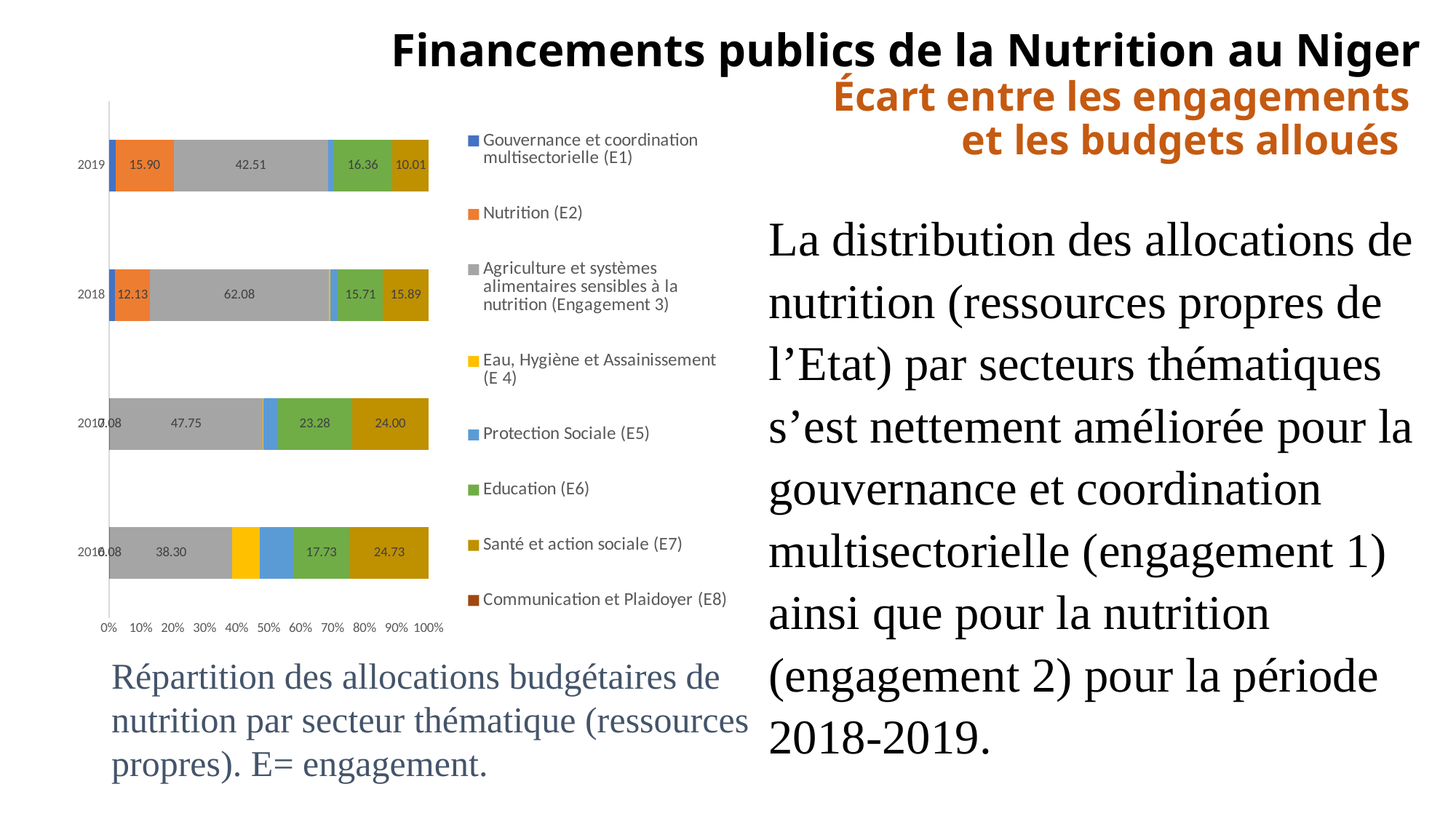
What kind of chart is shown on the slide? Stacked bar chart Which year has the larger value for Agriculture et systèmes alimentaires sensibles à la nutrition (Engagement 3), 2018 or 2019? 2018 What is the difference between the Nutrition (E2) value in 2019 and in 2018? 3.77 What is the value for Nutrition (E2) in 2018? 12.13 What is the value for Santé et action sociale (E7) in the bottom bar of the chart? 24.73 What is the value for Education (E6) in 2018? 15.71 How many series does the chart legend list? 8 Which series has the largest labelled segment in the 2019 bar? Agriculture et systèmes alimentaires sensibles à la nutrition (Engagement 3) What is the value for Agriculture et systèmes alimentaires sensibles à la nutrition (Engagement 3) in 2019? 42.51 What is the value for Santé et action sociale (E7) in 2019? 10.01 What colour represents Nutrition (E2) in the chart legend? Orange How many bars (years) are plotted in the chart? 4